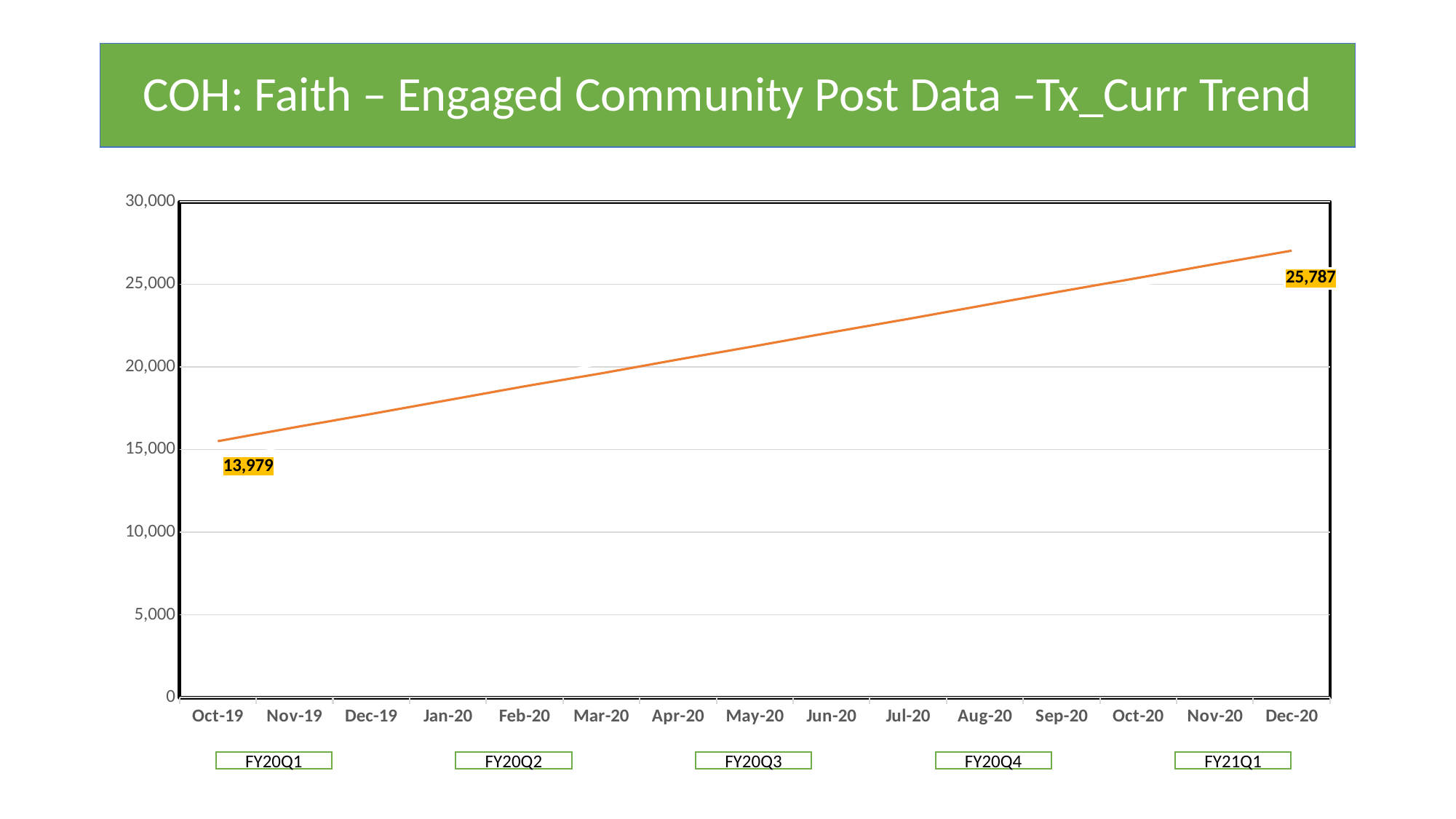
What kind of chart is shown on the slide? line chart Is the value for Jun-20 greater or less than 20,000? greater How many fiscal quarter labels (FY20Q1 to FY21Q1) are shown below the x axis? 5 Is the value for Jan-20 greater or less than 20,000? less What is the data label shown for Dec-20? 25,787 How many months are labelled on the x axis? 15 What is the difference between the Dec-20 value (25,787) and the Oct-19 value (13,979)? 11,808 Does the line rise or fall from Oct-19 to Dec-20? rise Is the value for Oct-19 greater or less than 20,000? less What is the title of the slide? COH: Faith – Engaged Community Post Data –Tx_Curr Trend What is the data label shown for Oct-19? 13,979 Which is larger, the value for Oct-19 or the value for Dec-20? Dec-20